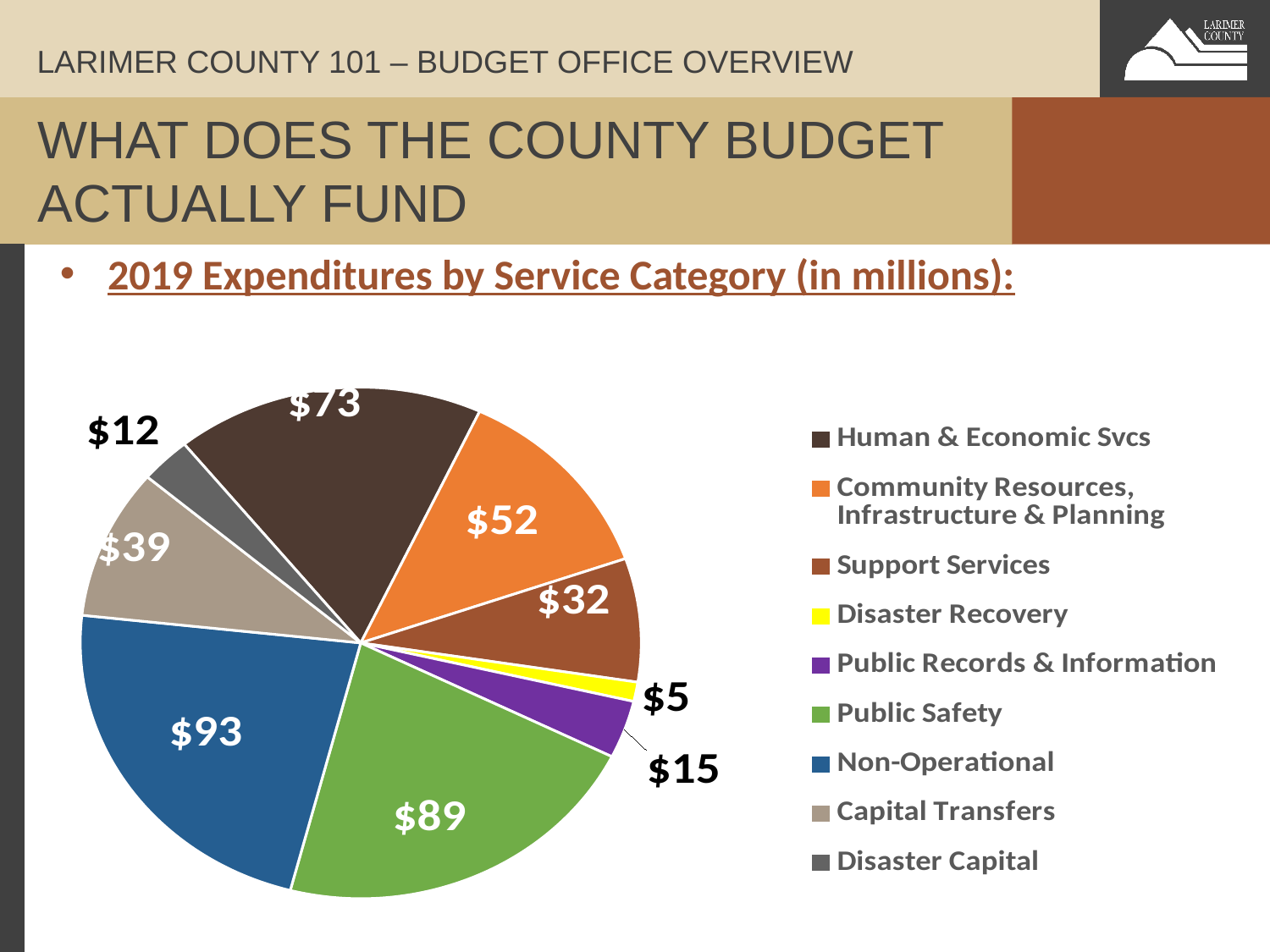
What type of chart is shown on the slide? Pie chart What is the title of the chart? 2019 Expenditures by Service Category (in millions): Which service category has the largest expenditure? Non-Operational What is the value for Community Resources, Infrastructure & Planning? $52 How many service categories are shown in the pie chart? 9 What is the value for Disaster Recovery? $5 What is the value for Human & Economic Svcs? $73 What is the value for Public Safety? $89 What is the difference between the Non-Operational and Public Safety values? $4 Which service category has the smallest expenditure? Disaster Recovery Which is larger, Support Services or Capital Transfers? Capital Transfers What is the total of all expenditures shown in the pie chart? $410